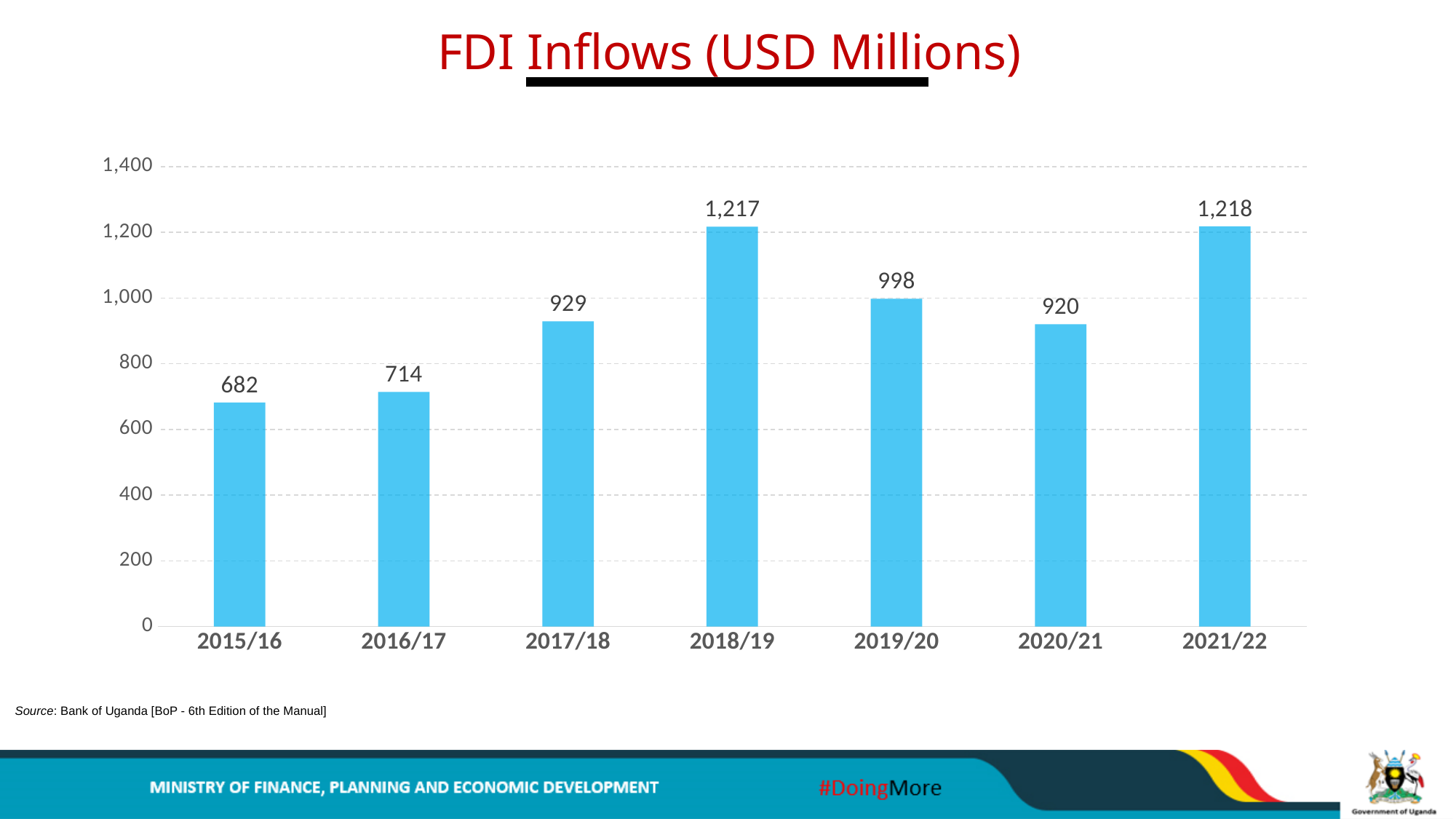
What is the difference between the FDI inflows for 2018/19 and 2017/18? 288 Is the FDI inflow for 2017/18 greater or less than 1,000? less How many years are shown on the chart? 7 What is the FDI inflow value for 2020/21? 920 Do FDI inflows rise or fall from 2015/16 to 2018/19? rise Which year has the lowest FDI inflow? 2015/16 What is the difference between the FDI inflows for 2019/20 and 2020/21? 78 What is the title of the chart? FDI Inflows (USD Millions) What is the FDI inflow value for 2015/16? 682 What kind of chart is shown on the slide? bar chart Which year has the larger FDI inflow, 2019/20 or 2016/17? 2019/20 What is the FDI inflow value for 2018/19? 1,217